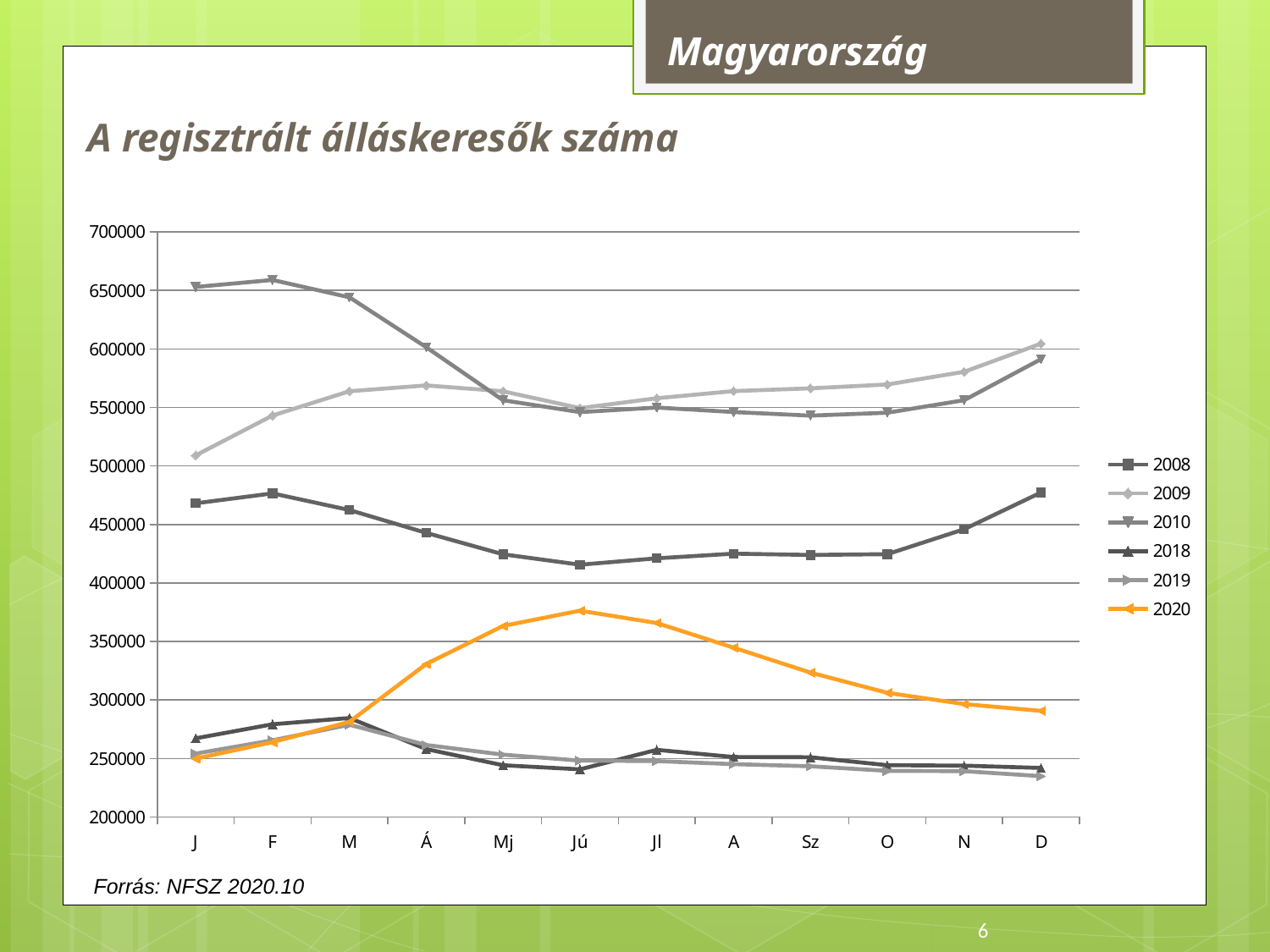
Is the value for 2019 in D greater or less than 250000? less Is the value for 2020 in Jú greater or less than 350000? greater In which month does the 2020 series reach its highest value? Jú Is the value for 2010 in F greater or less than 650000? greater How many series does the legend list? 6 Does the 2020 series rise or fall from Jú to D? fall Which series has the highest value in January (J)? 2010 Which is larger in D: the value for 2008 or the value for 2020? 2008 What kind of chart is shown on the slide? line chart In which month is the 2020 series at its lowest value? J What is the title of the chart? A regisztrált álláskeresők száma How many months are plotted along the x axis? 12